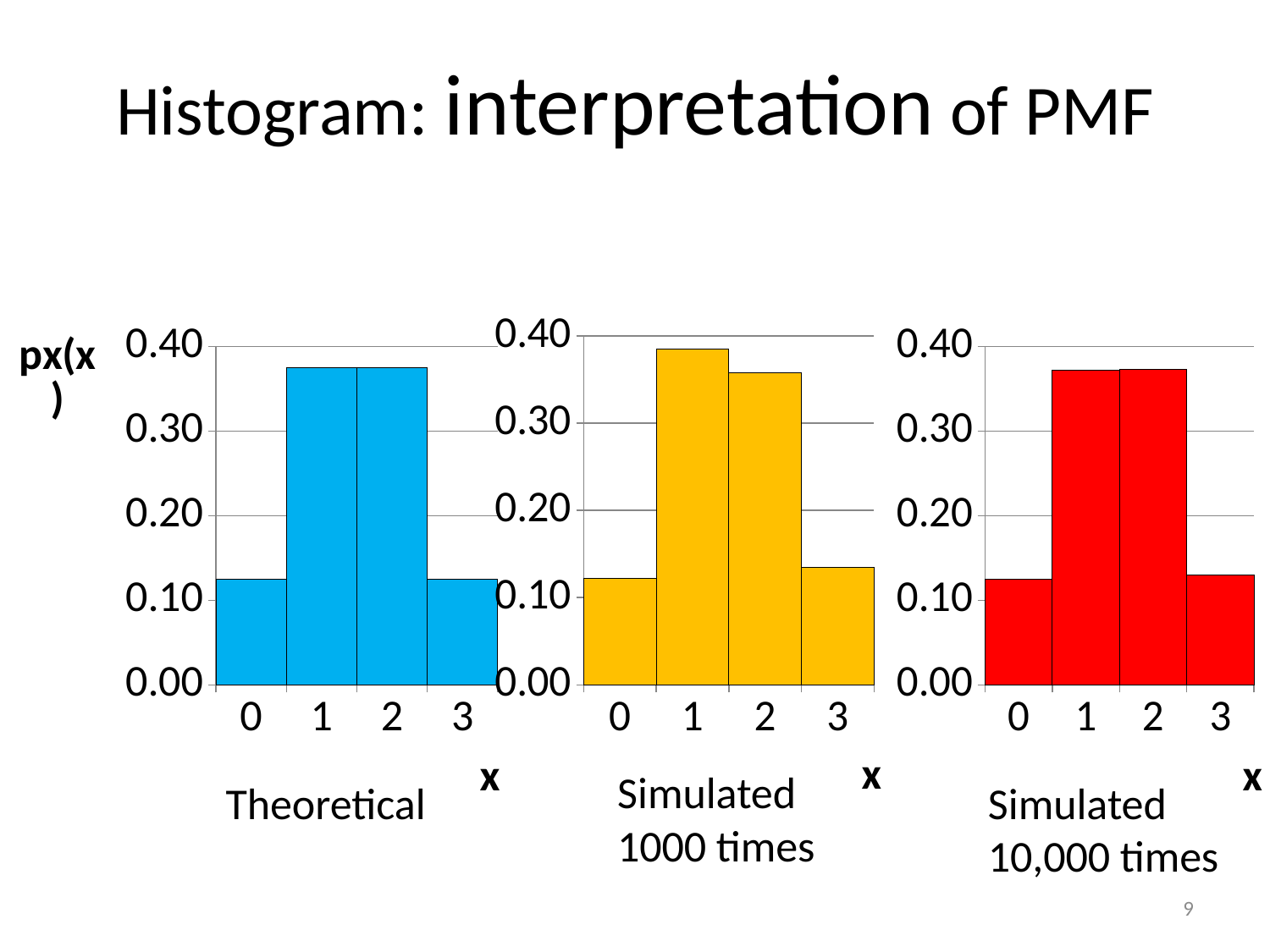
In the Theoretical chart, is the value for x = 1 greater or less than 0.30? greater In the Simulated 1000 times chart, is the value for x = 3 greater or less than 0.10? greater In the Simulated 10,000 times chart, is the value for x = 1 greater or less than 0.40? less In the Simulated 1000 times chart, is the bar for x = 1 or the bar for x = 2 taller? 1 How many charts are shown on the slide? 3 What colour are the bars in the Theoretical chart? blue In the Simulated 1000 times chart, which x value has the highest bar? 1 In the Theoretical chart, how many categories are shown on the x axis? 4 What kind of chart is the Simulated 1000 times chart? bar chart